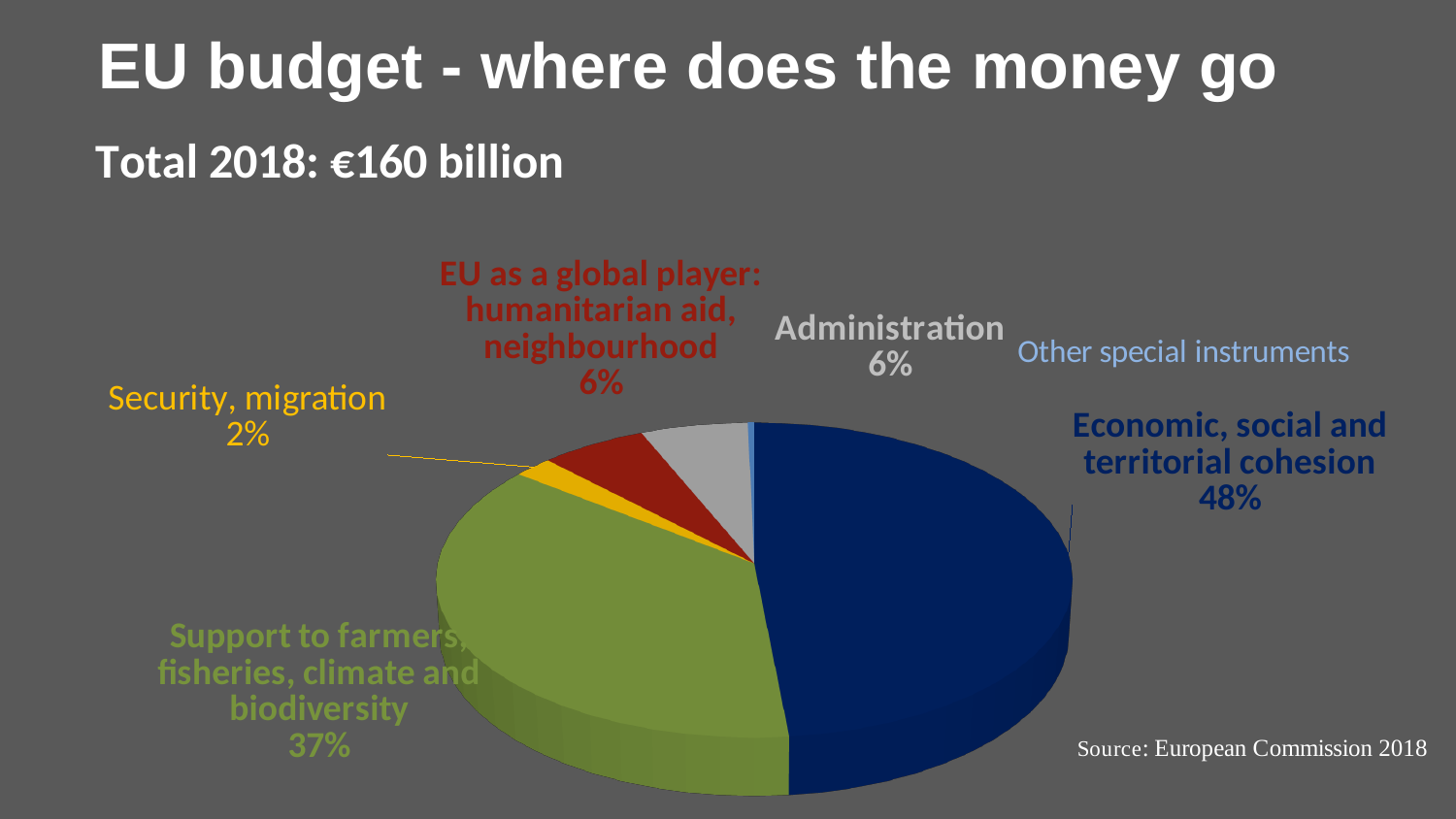
What share of the EU budget goes to Support to farmers, fisheries, climate and biodiversity? 37% What is the difference in percentage points between the share for Economic, social and territorial cohesion and the share for Support to farmers, fisheries, climate and biodiversity? 11 percentage points Which category has the largest share of the EU budget? Economic, social and territorial cohesion What source is cited for the chart? European Commission 2018 How many categories are shown in the pie chart? 6 What share of the EU budget goes to EU as a global player: humanitarian aid, neighbourhood? 6% What share of the EU budget goes to Administration? 6% Which is larger: the share for Support to farmers, fisheries, climate and biodiversity or the share for Economic, social and territorial cohesion? Economic, social and territorial cohesion What is the total EU budget for 2018 stated on the slide? €160 billion What kind of chart is shown on the slide? Pie chart